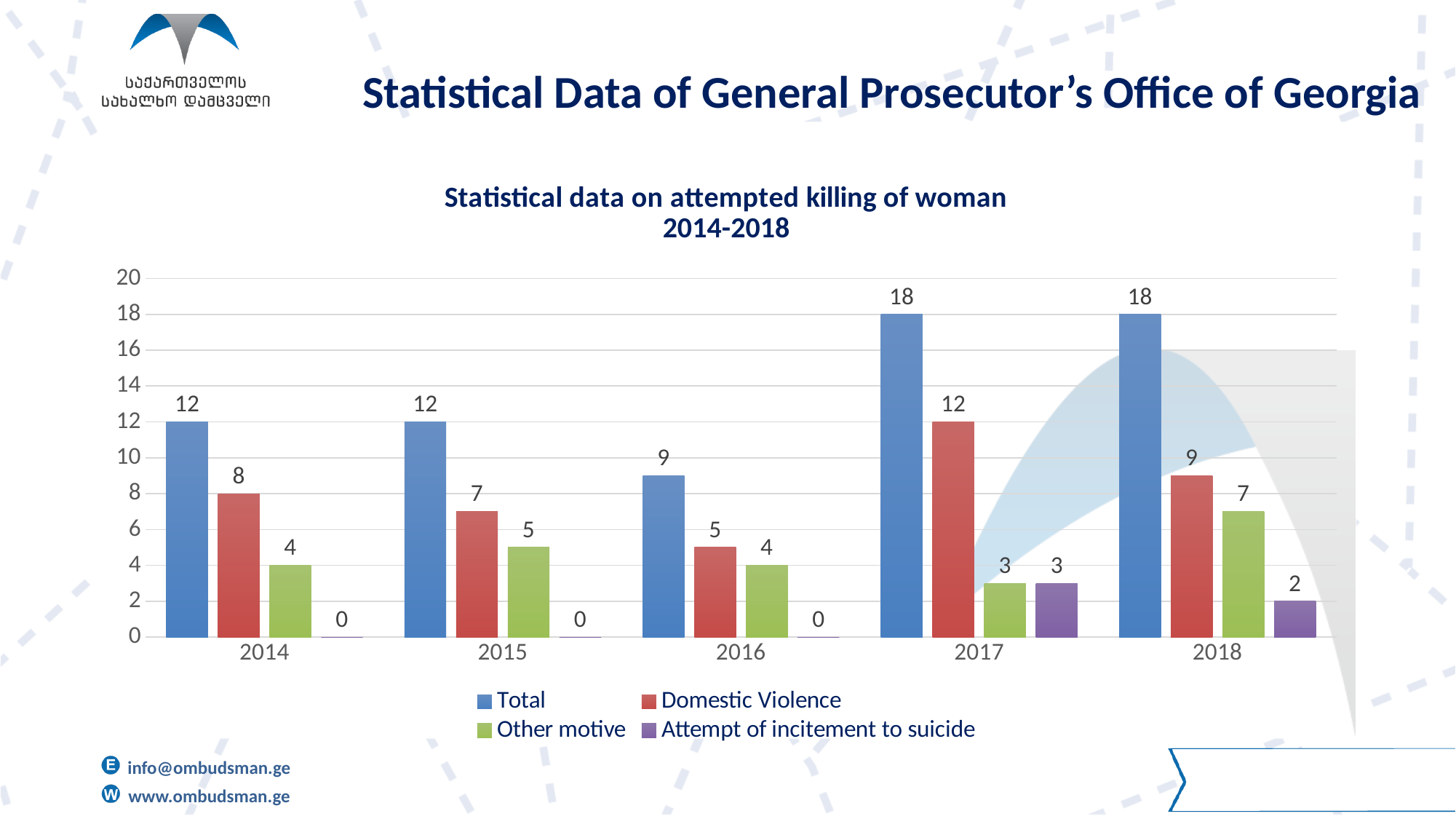
What kind of chart is shown on the slide? bar chart What is the Attempt of incitement to suicide value for 2014? 0 How many years are shown on the x axis? 5 What is the title of the chart? Statistical data on attempted killing of woman 2014-2018 Which year has the highest Domestic Violence value? 2017 What is the difference between the Total value for 2017 and the Total value for 2016? 9 What is the Other motive value for 2018? 7 Which is larger, the Domestic Violence value for 2014 or the Domestic Violence value for 2016? 2014 What is the Domestic Violence value for 2015? 7 What is the Total value for 2017? 18 How many series does the legend list? 4 Which year has the lowest Total value? 2016